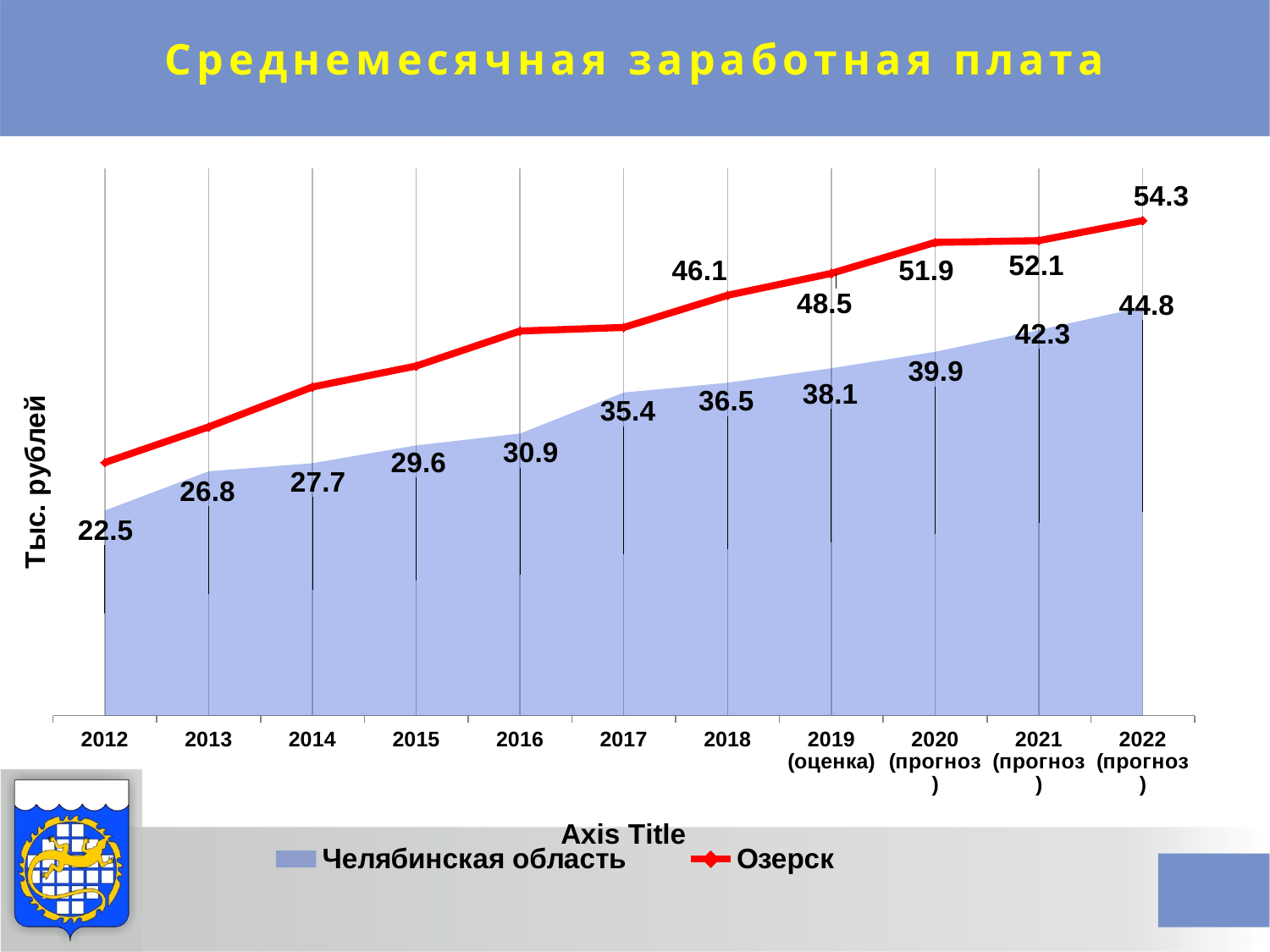
How many series does the legend list? 2 How many years are shown on the x axis? 11 What is the value for Озерск in 2019 (оценка)? 48.5 In which year is the value for Челябинская область the lowest? 2012 What is the value for Челябинская область in 2012? 22.5 What is the value for Озерск in 2022 (прогноз)? 54.3 In which year is the value for Челябинская область the highest? 2022 (прогноз) Do the values for Челябинская область rise or fall from 2012 to 2022? rise What is the value for Челябинская область in 2017? 35.4 Which series has the larger value in 2018, Озерск or Челябинская область? Озерск What is the label on the vertical axis? Тыс. рублей What is the difference between the Озерск and Челябинская область values in 2020 (прогноз)? 12.0